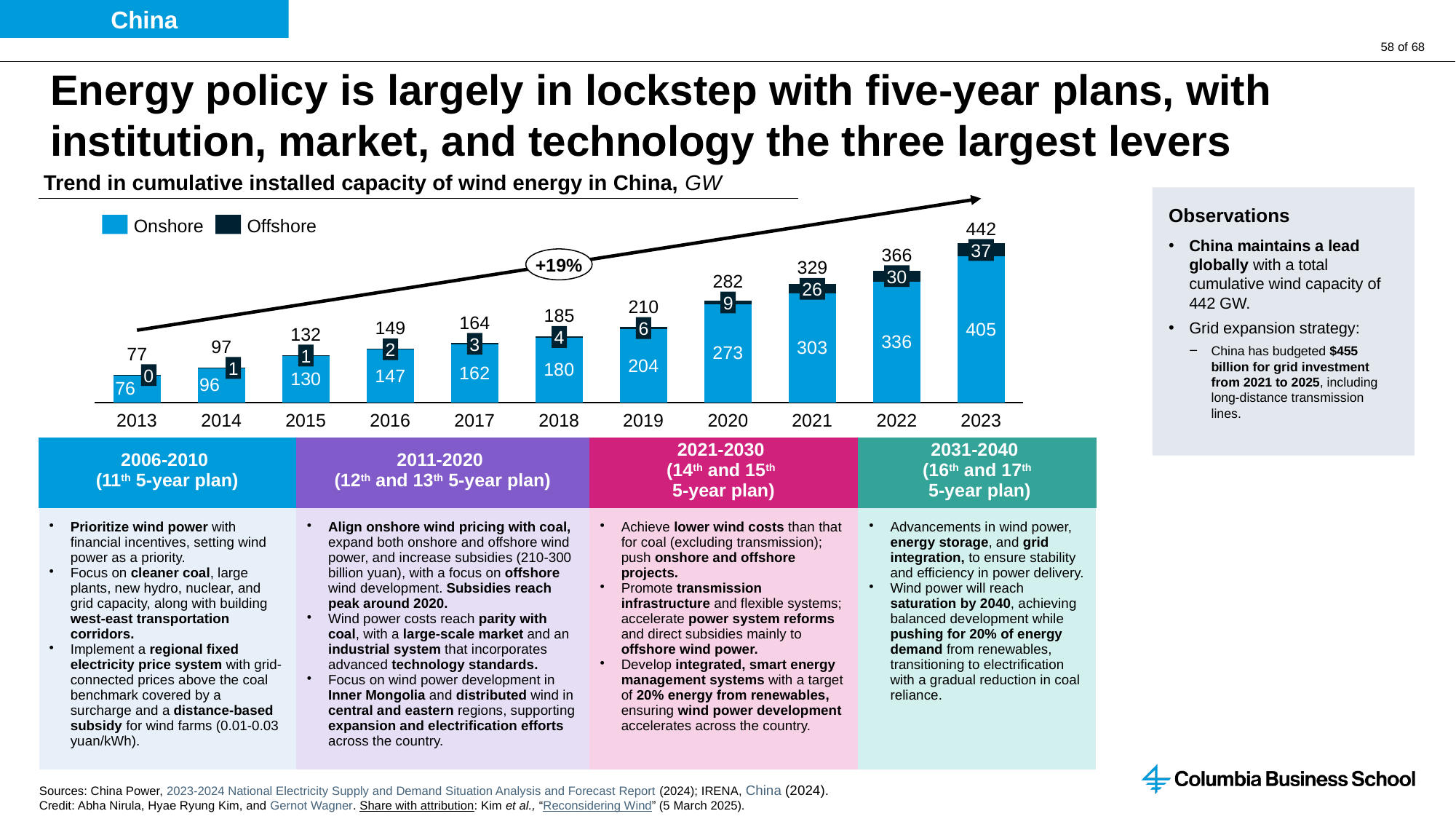
Which year has the highest total cumulative installed wind capacity? 2023 What annual growth rate is labelled on the arrow above the bars? +19% What is the onshore wind capacity shown for 2023? 405 Does the total cumulative installed wind capacity rise or fall from 2013 to 2023? Rise What is the total cumulative installed wind capacity labelled for 2020? 282 Which year has the lowest total cumulative installed wind capacity? 2013 What is the difference between the total capacity labelled for 2023 and for 2022? 76 How many series does the chart legend list? 2 What is the offshore wind capacity shown for 2021? 26 What kind of chart is used to show the trend in cumulative installed wind capacity? Stacked bar chart Which is larger, the onshore capacity in 2019 or the onshore capacity in 2018? 2019 How many years are shown on the x axis of the chart? 11